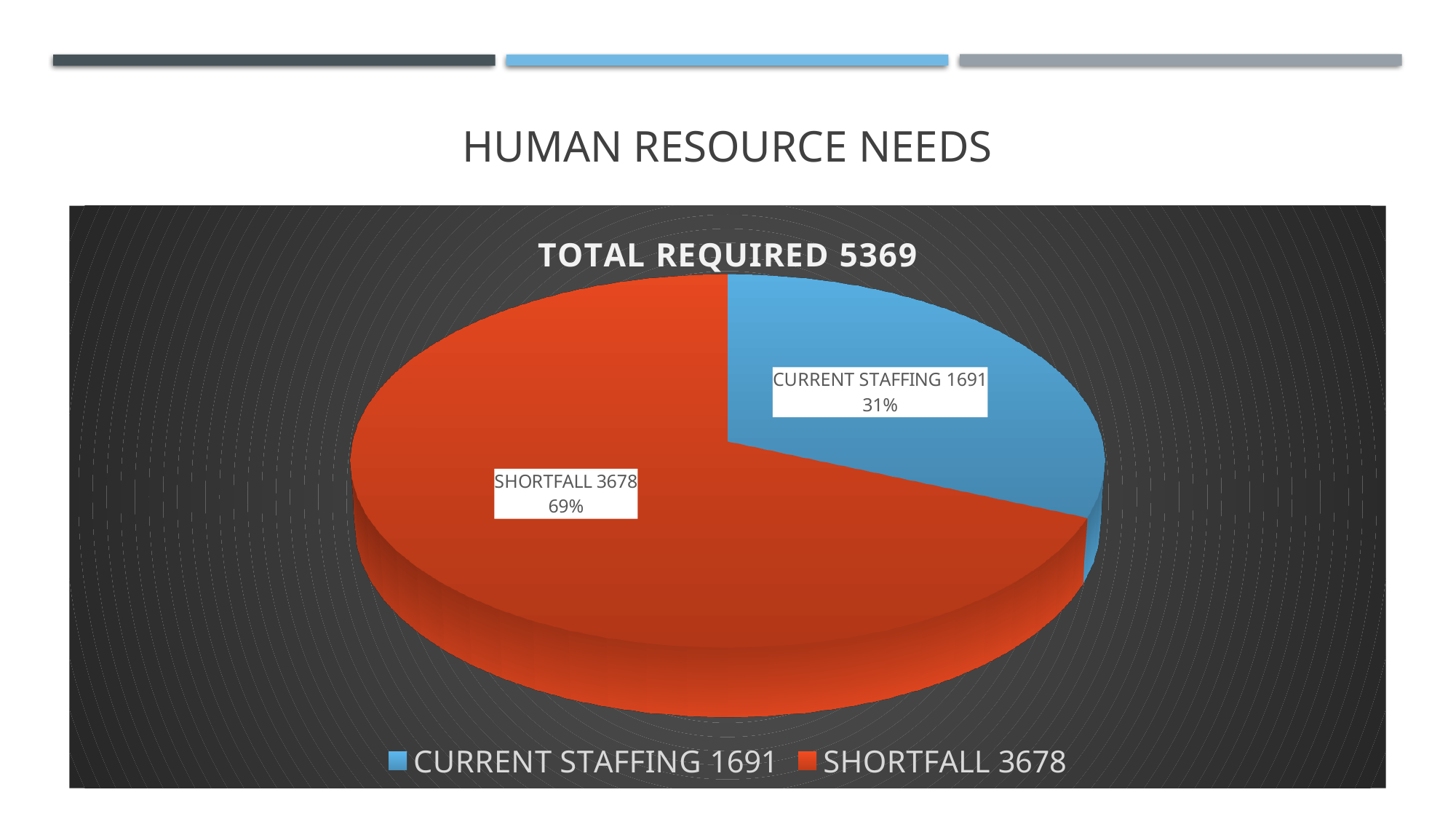
What percentage share of the pie does CURRENT STAFFING 1691 represent? 31% What kind of chart is shown on the slide? Pie chart How many slices does the pie chart have? 2 Is the share for CURRENT STAFFING 1691 greater or less than 50%? less Which slice of the pie is the largest? SHORTFALL 3678 How many entries does the legend list? 2 What percentage share of the pie does SHORTFALL 3678 represent? 69% Which is larger, the share for SHORTFALL 3678 or the share for CURRENT STAFFING 1691? SHORTFALL 3678 What is the difference in percentage points between the SHORTFALL 3678 share and the CURRENT STAFFING 1691 share? 38 percentage points What is the title of the chart? TOTAL REQUIRED 5369 What colour is the SHORTFALL 3678 slice? Red Which slice of the pie is the smallest? CURRENT STAFFING 1691